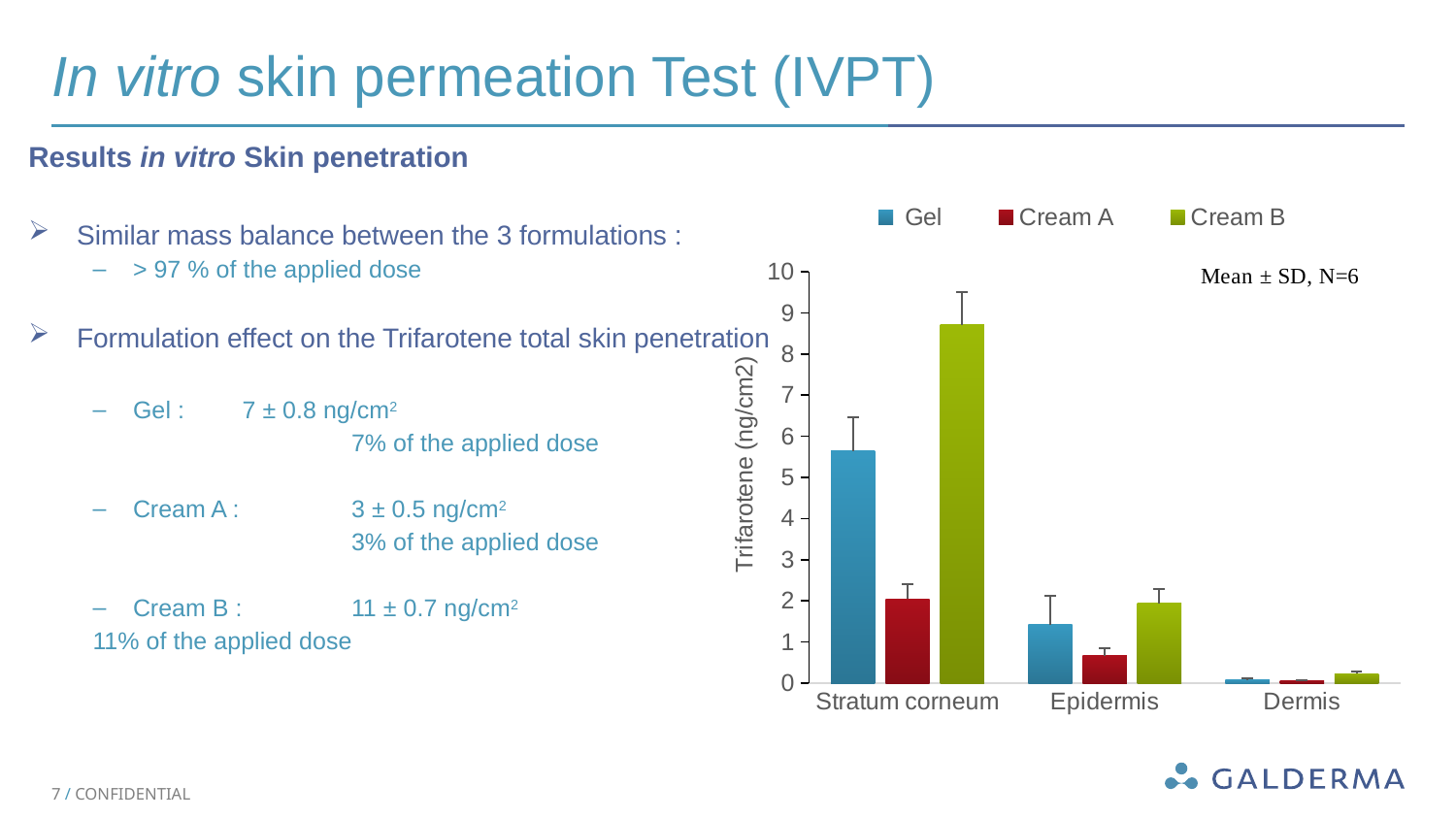
Is the Cream A value for Epidermis greater or less than 1? less In the Epidermis category, which is larger: the Gel bar or the Cream A bar? Gel What is the label of the y axis of the chart? Trifarotene (ng/cm2) Is the Gel value for Stratum corneum greater or less than 5? greater Which series is shown in red in the chart? Cream A Which series has the lowest bar in the Stratum corneum category? Cream A How many categories are shown on the x axis of the chart? 3 What kind of chart is shown on the slide? bar chart How many series does the chart legend list? 3 Which series has the highest bar in the Stratum corneum category? Cream B Is the Cream B value for Stratum corneum greater or less than 8? greater Which category has the lowest bars overall? Dermis